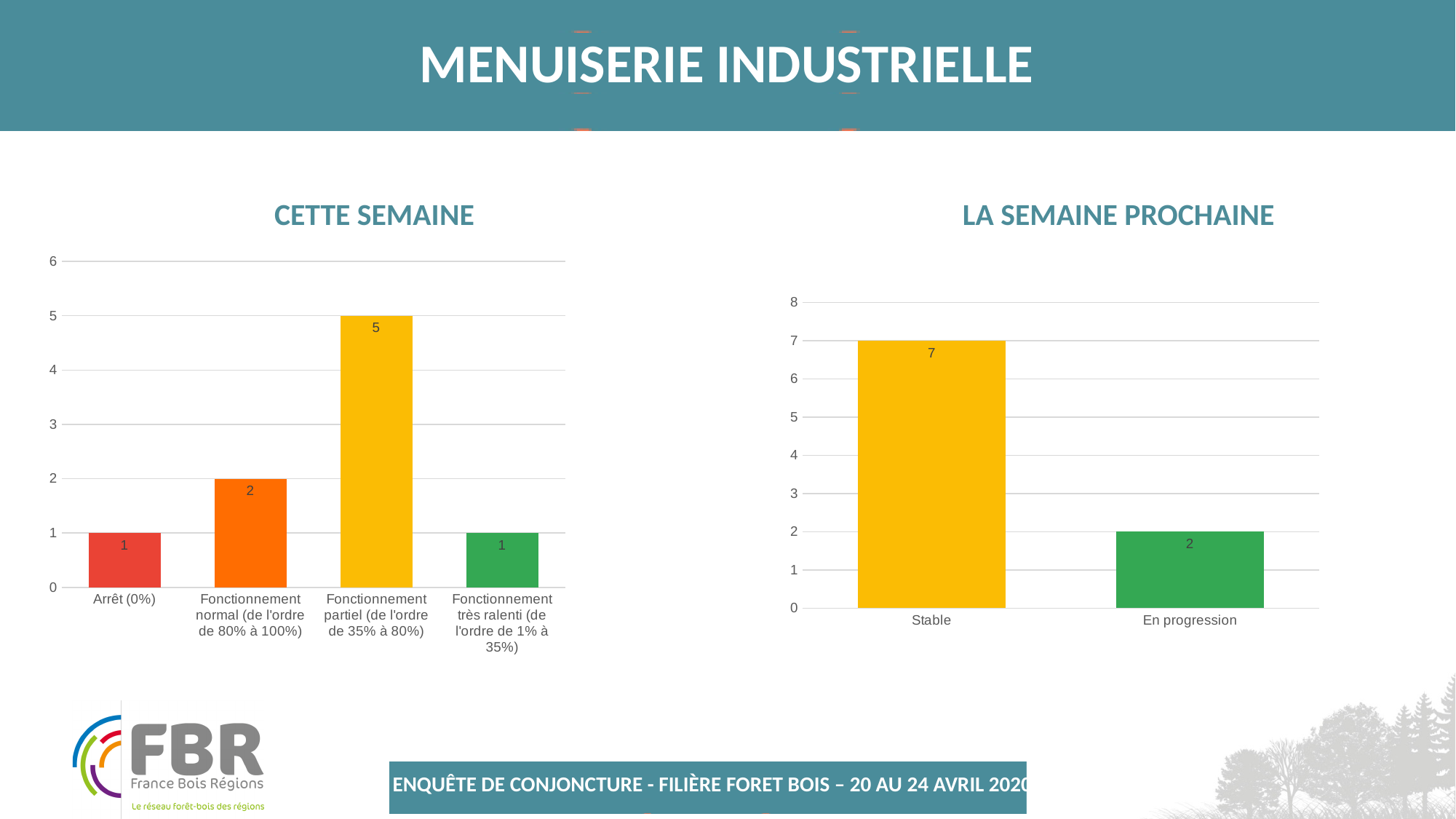
In the 'CETTE SEMAINE' chart, what is the value for 'Fonctionnement partiel (de l'ordre de 35% à 80%)'? 5 What type of chart is the 'LA SEMAINE PROCHAINE' chart? bar chart In the 'LA SEMAINE PROCHAINE' chart, what is the value for 'Stable'? 7 In the 'CETTE SEMAINE' chart, what colour is the bar for 'Arrêt (0%)'? red In the 'LA SEMAINE PROCHAINE' chart, what is the difference between the values for 'Stable' and 'En progression'? 5 In the 'LA SEMAINE PROCHAINE' chart, what is the value for 'En progression'? 2 In the 'CETTE SEMAINE' chart, how many categories are shown? 4 In the 'CETTE SEMAINE' chart, which category has the highest value? Fonctionnement partiel (de l'ordre de 35% à 80%) In the 'LA SEMAINE PROCHAINE' chart, which category has the lowest value? En progression In the 'CETTE SEMAINE' chart, is the value for 'Arrêt (0%)' larger or smaller than the value for 'Fonctionnement normal'? smaller In the 'CETTE SEMAINE' chart, what is the value for 'Fonctionnement normal (de l'ordre de 80% à 100%)'? 2 In the 'CETTE SEMAINE' chart, what is the difference between the values for 'Fonctionnement partiel' and 'Fonctionnement normal'? 3